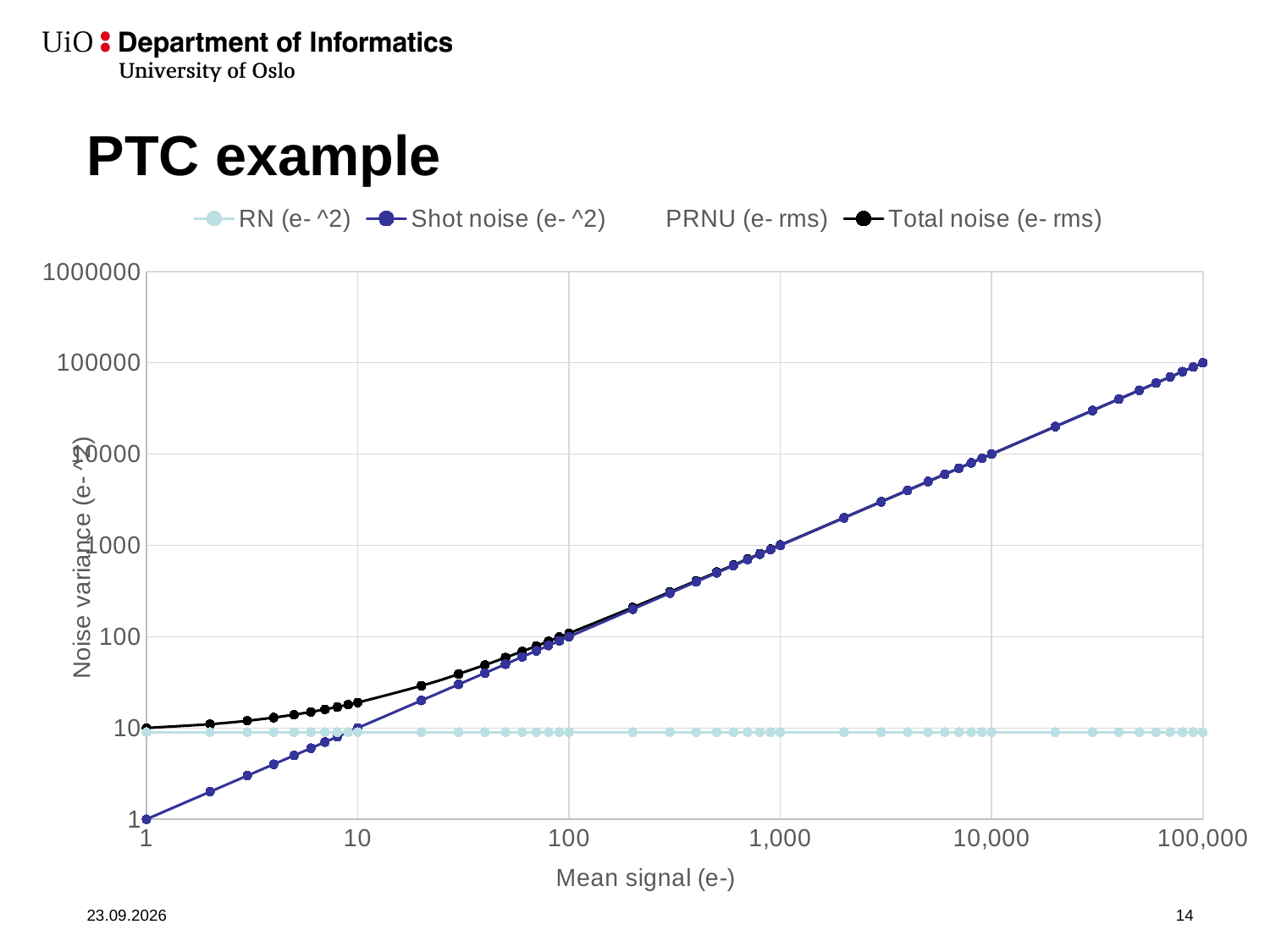
What is the label of the x axis? Mean signal (e-) How many series does the chart legend list? 4 At a mean signal of 1, which is larger: Total noise (e- rms) or Shot noise (e- ^2)? Total noise (e- rms) At a mean signal of 100,000, which is larger: Shot noise (e- ^2) or RN (e- ^2)? Shot noise (e- ^2) What is the Shot noise (e- ^2) value at a mean signal of 100,000? 100000 Is the Total noise (e- rms) value at a mean signal of 1 greater or less than 100? less What is the Shot noise (e- ^2) value at a mean signal of 1? 1 Do the Shot noise (e- ^2) values rise or fall as mean signal increases along the x axis? rise Is the Total noise (e- rms) value at a mean signal of 10 greater or less than 10? greater What is the Shot noise (e- ^2) value at a mean signal of 100? 100 What kind of chart is shown on the slide? line chart Is the RN (e- ^2) value at a mean signal of 1,000 greater or less than 100? less